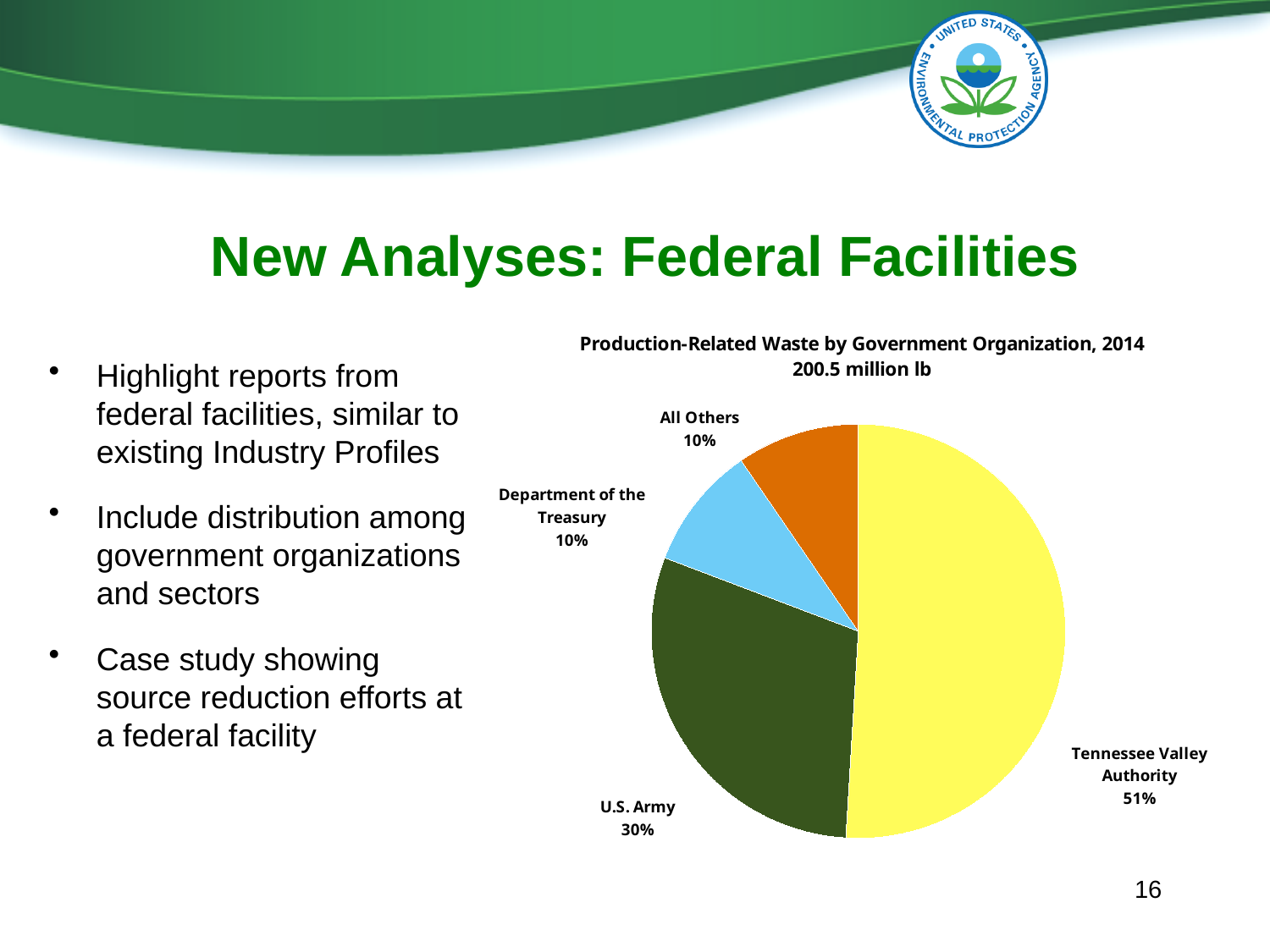
Which government organization has the largest share of production-related waste? Tennessee Valley Authority What type of chart is shown on the slide? pie chart What share of production-related waste is attributed to the Tennessee Valley Authority? 51% What total amount of production-related waste is stated in the chart title? 200.5 million lb What is the difference in percentage points between the Tennessee Valley Authority share and the U.S. Army share? 21 percentage points What is the combined share of the U.S. Army and the Department of the Treasury? 40% What share of production-related waste is attributed to the Department of the Treasury? 10% What share of production-related waste is attributed to the U.S. Army? 30% What is the title of the chart? Production-Related Waste by Government Organization, 2014 What share of production-related waste is attributed to All Others? 10% Which has a larger share of production-related waste, the U.S. Army or the Department of the Treasury? U.S. Army How many slices does the pie chart have? 4